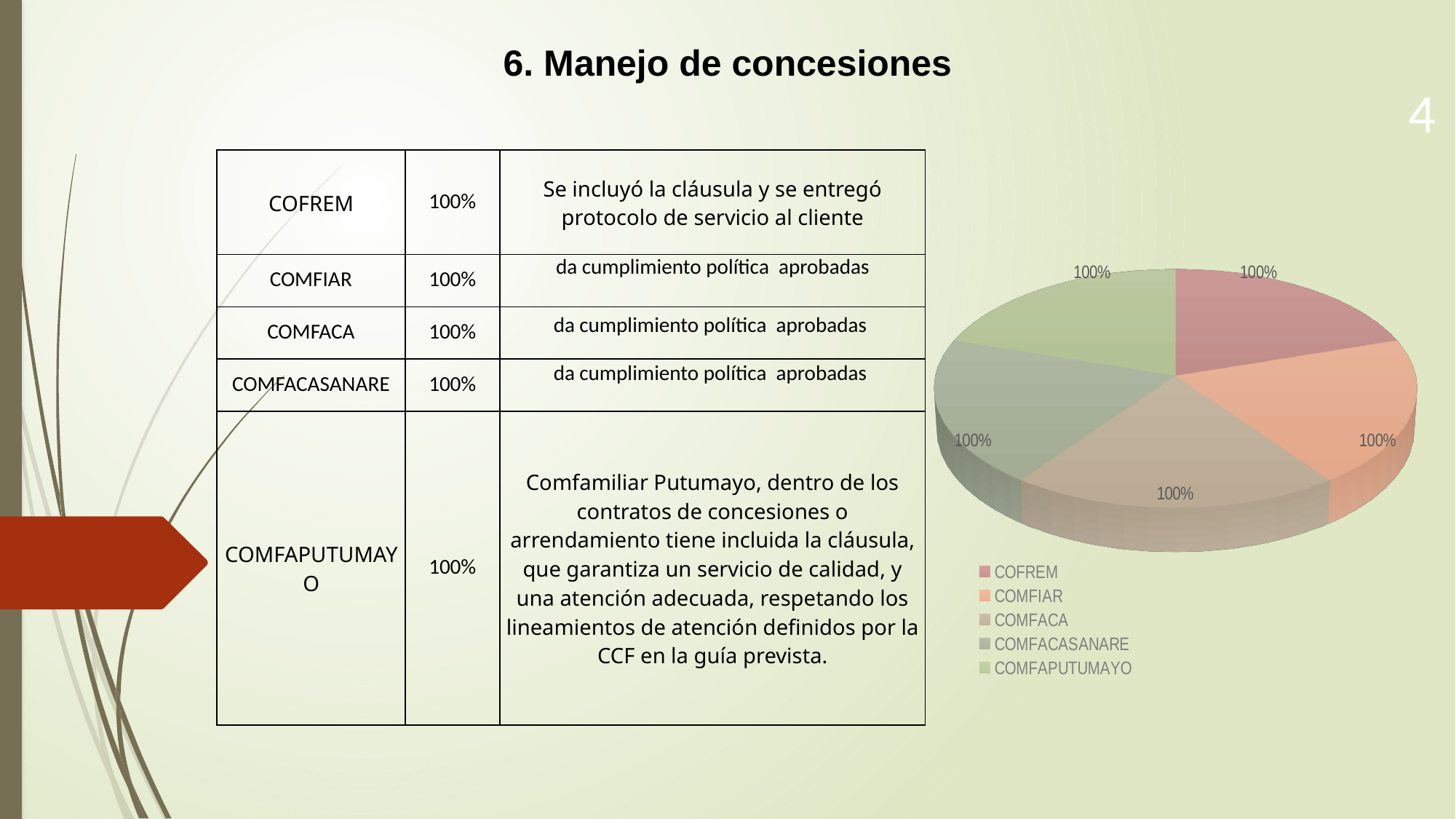
What kind of chart is shown on the slide? pie chart How many slices does the pie chart have? 5 Which entry is listed first in the pie chart's legend? COFREM What value is shown for COMFAPUTUMAYO in the pie chart? 100% How many entries does the pie chart's legend list? 5 What value is shown for COMFACA in the pie chart? 100% What value is shown for COMFIAR in the pie chart? 100% What is the difference between the values shown for COFREM and COMFACA in the pie chart? 0% Which entry is listed last in the pie chart's legend? COMFAPUTUMAYO What value is shown for COMFACASANARE in the pie chart? 100% What value is shown for COFREM in the pie chart? 100%